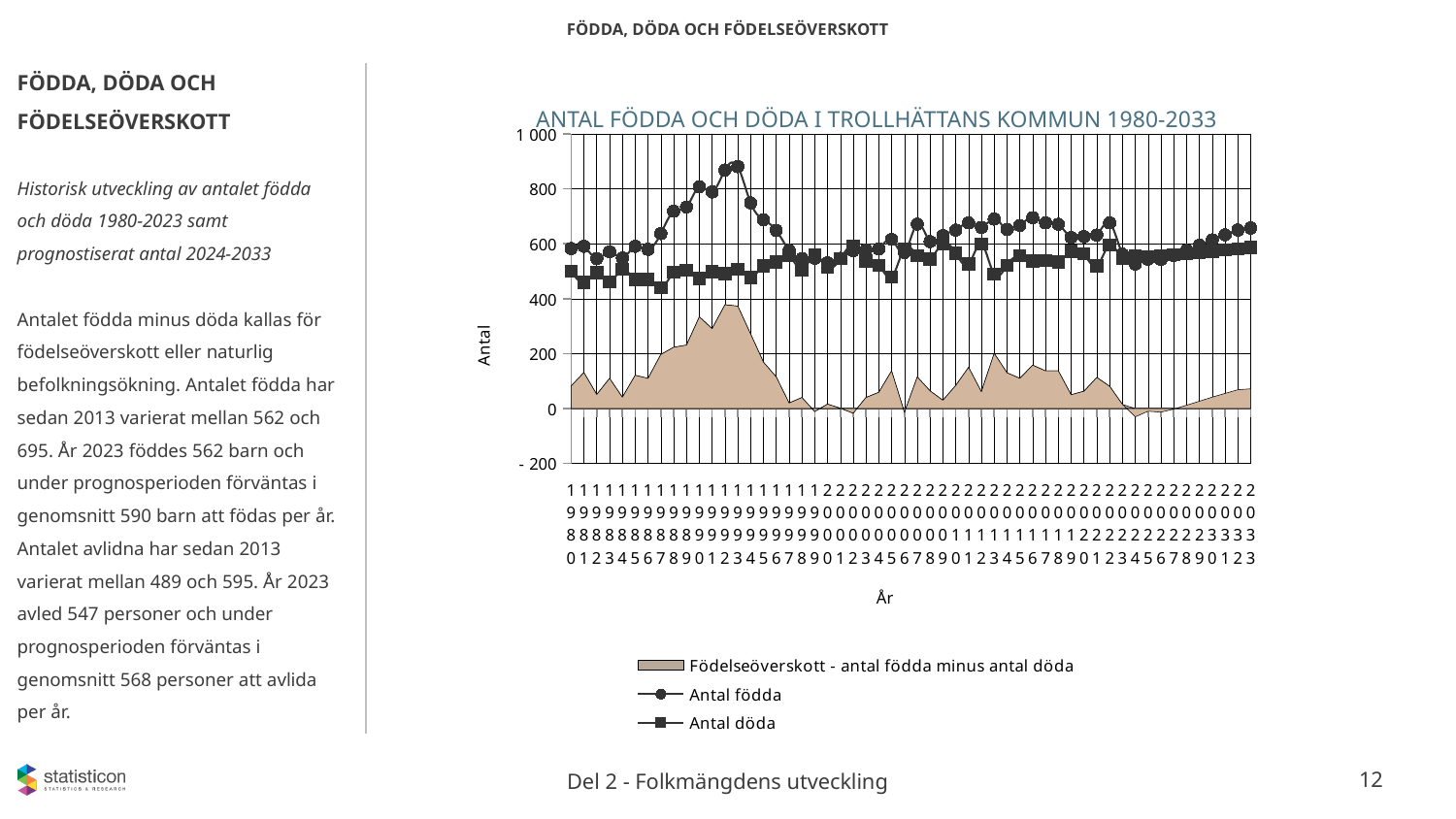
In which year does Antal födda reach its highest value? 1993 How many series does the chart's legend list? 3 Is the value for Antal döda in 1980 greater or less than 600? less What kind of chart is used to show the series Antal födda and Antal döda? line chart Is the value for Antal födda in 2023 greater or less than 600? less Does Antal födda rise or fall between 1985 and 1991? rise What is the label of the vertical axis? Antal How many years are plotted along the x axis? 54 Is the value for Födelseöverskott in 1991 greater or less than 200? greater In 1991, which is larger, Antal födda or Antal döda? Antal födda What is the title of the chart? ANTAL FÖDDA OCH DÖDA I TROLLHÄTTANS KOMMUN 1980-2033